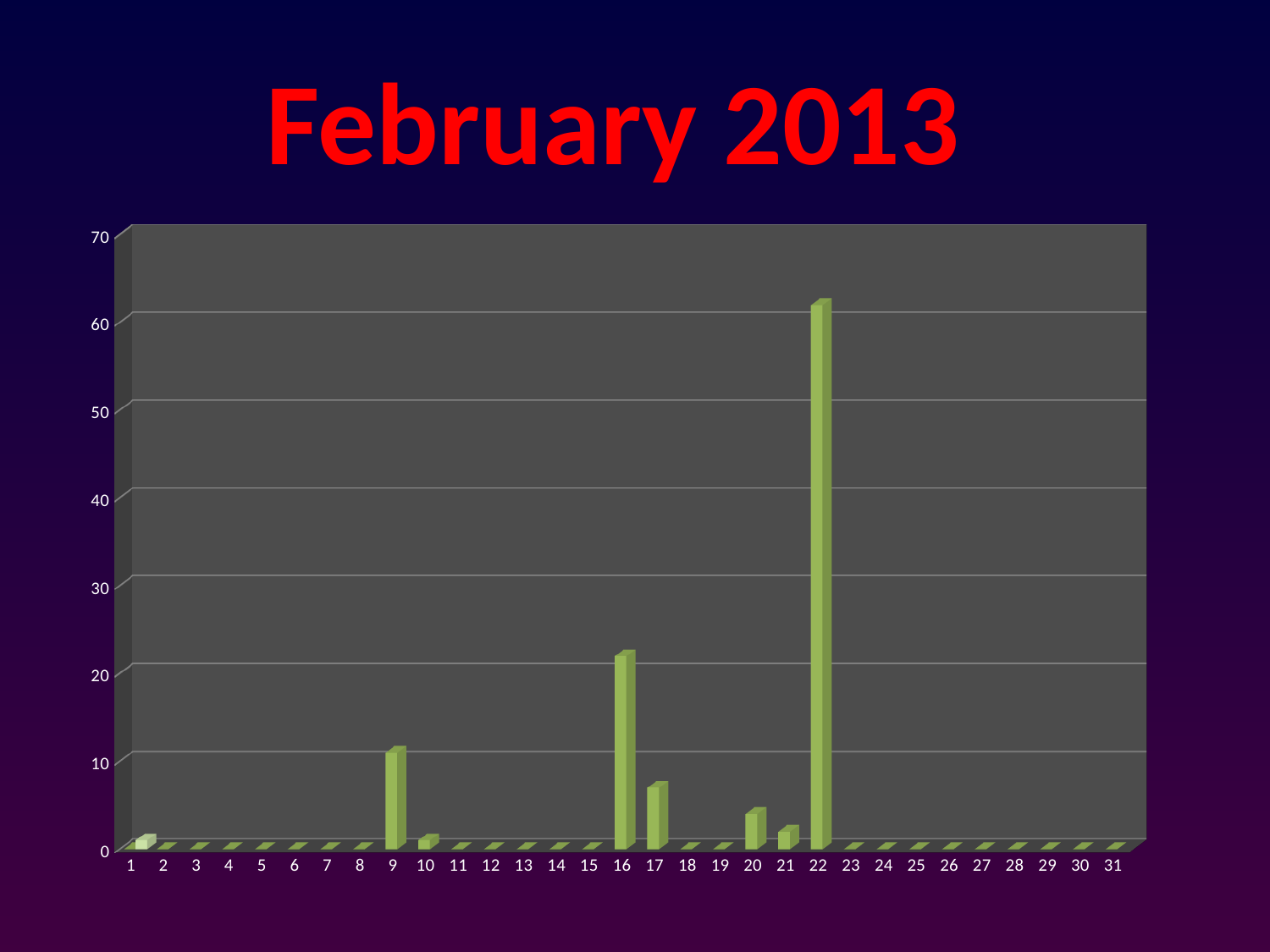
What is the highest value shown on the y axis? 70 How many categories are shown on the x axis? 31 What is the title of the slide? February 2013 Which has the larger value, category 17 or category 22? 22 Is the value for category 16 greater or less than 20? greater Which has the larger value, category 16 or category 9? 16 Which category on the x axis has the highest bar? 22 Is the value for category 20 greater or less than 10? less Is the value for category 17 greater or less than 10? less What kind of chart is shown on the slide? bar chart